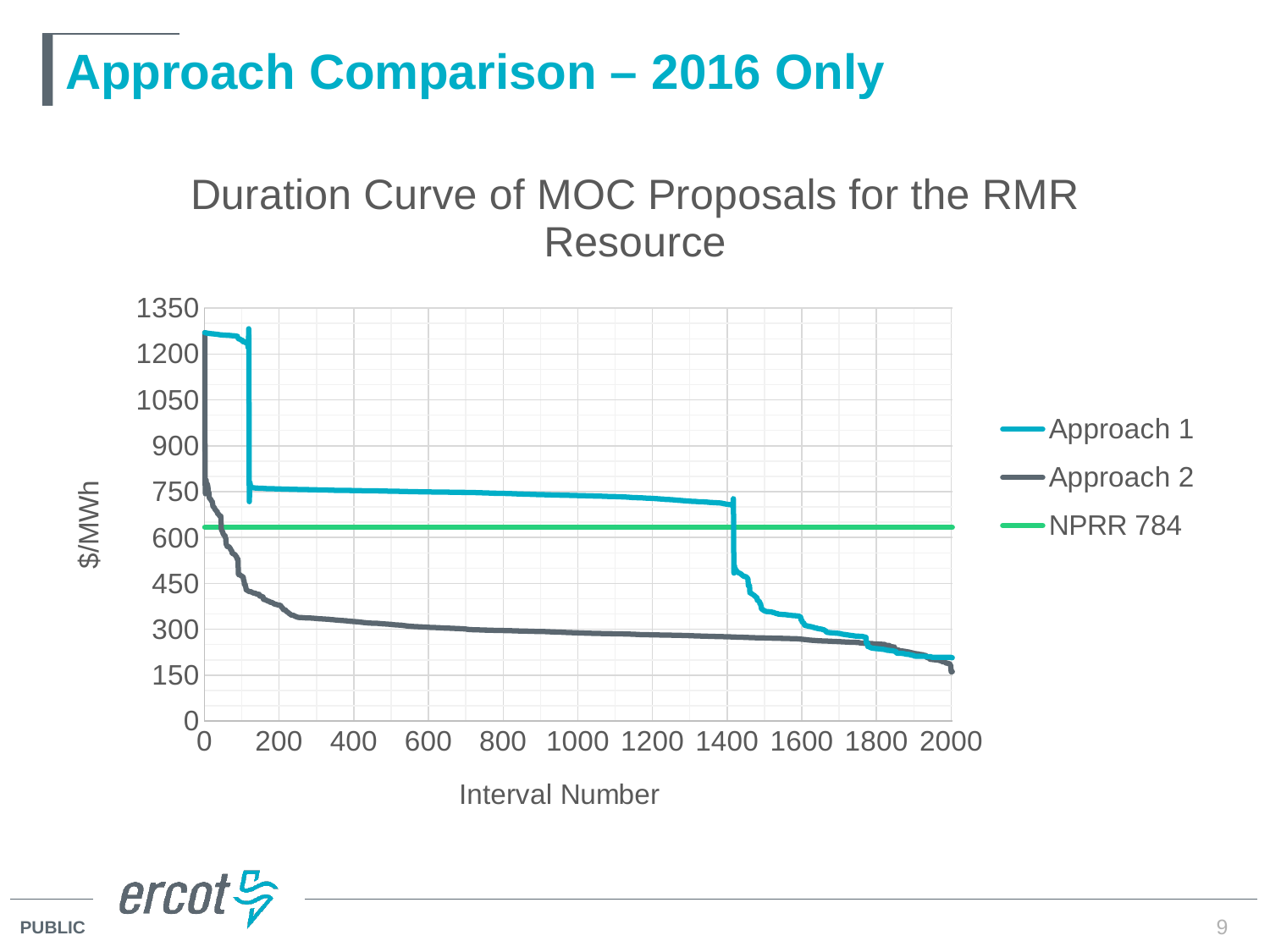
What is the label of the x axis? Interval Number At interval number 1000, which series has the higher value, Approach 1 or Approach 2? Approach 1 What is the title of the chart? Duration Curve of MOC Proposals for the RMR Resource Is the value for NPRR 784 greater or less than 750? less What kind of chart is shown on the slide? Line chart Is the value for Approach 2 at interval number 1000 greater or less than 450? less Is the value for Approach 1 at interval number 1600 greater or less than 450? less Do the values for Approach 1 rise or fall as the interval number increases? Fall Do the values for Approach 2 rise or fall as the interval number increases? Fall How many series does the legend list? 3 At interval number 600, which series has the lower value, Approach 1 or Approach 2? Approach 2